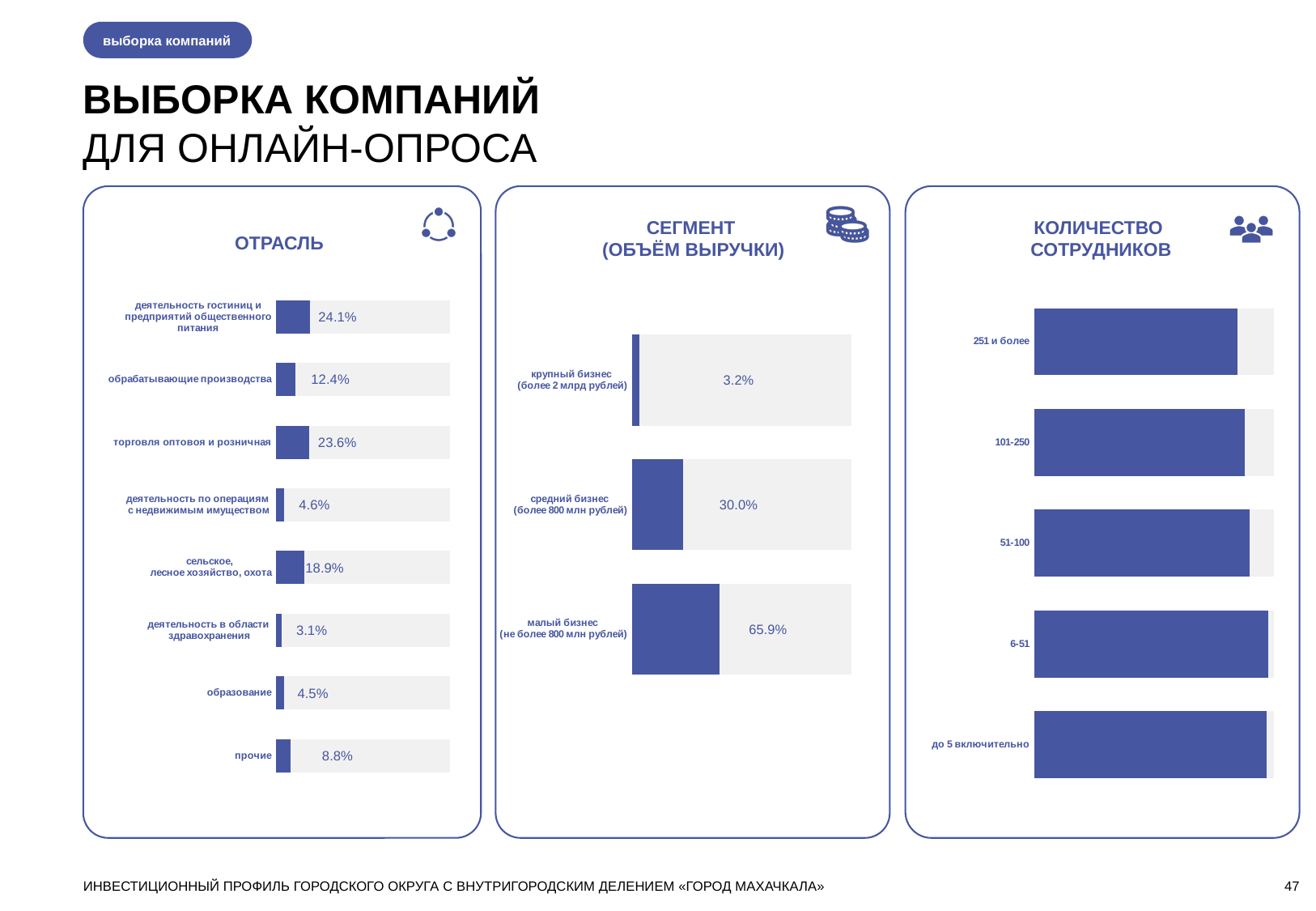
On the СЕГМЕНТ (ОБЪЁМ ВЫРУЧКИ) chart, which is larger: крупный бизнес or средний бизнес? средний бизнес On the СЕГМЕНТ (ОБЪЁМ ВЫРУЧКИ) chart, what is the difference between малый бизнес and крупный бизнес? 62.7% On the ОТРАСЛЬ chart, what is the value for образование? 4.5% On the СЕГМЕНТ (ОБЪЁМ ВЫРУЧКИ) chart, which segment has the highest value? малый бизнес On the КОЛИЧЕСТВО СОТРУДНИКОВ chart, how many categories are shown? 5 On the ОТРАСЛЬ chart, which category has the highest value? деятельность гостиниц и предприятий общественного питания On the ОТРАСЛЬ chart, what is the value for торговля оптовая и розничная? 23.6% On the ОТРАСЛЬ chart, how many categories are shown? 8 On the ОТРАСЛЬ chart, which category has the lowest value? деятельность в области здравоохранения On the ОТРАСЛЬ chart, what is the difference between обрабатывающие производства and прочие? 3.6% On the СЕГМЕНТ (ОБЪЁМ ВЫРУЧКИ) chart, what is the value for средний бизнес? 30.0% What type of chart is the КОЛИЧЕСТВО СОТРУДНИКОВ chart? bar chart